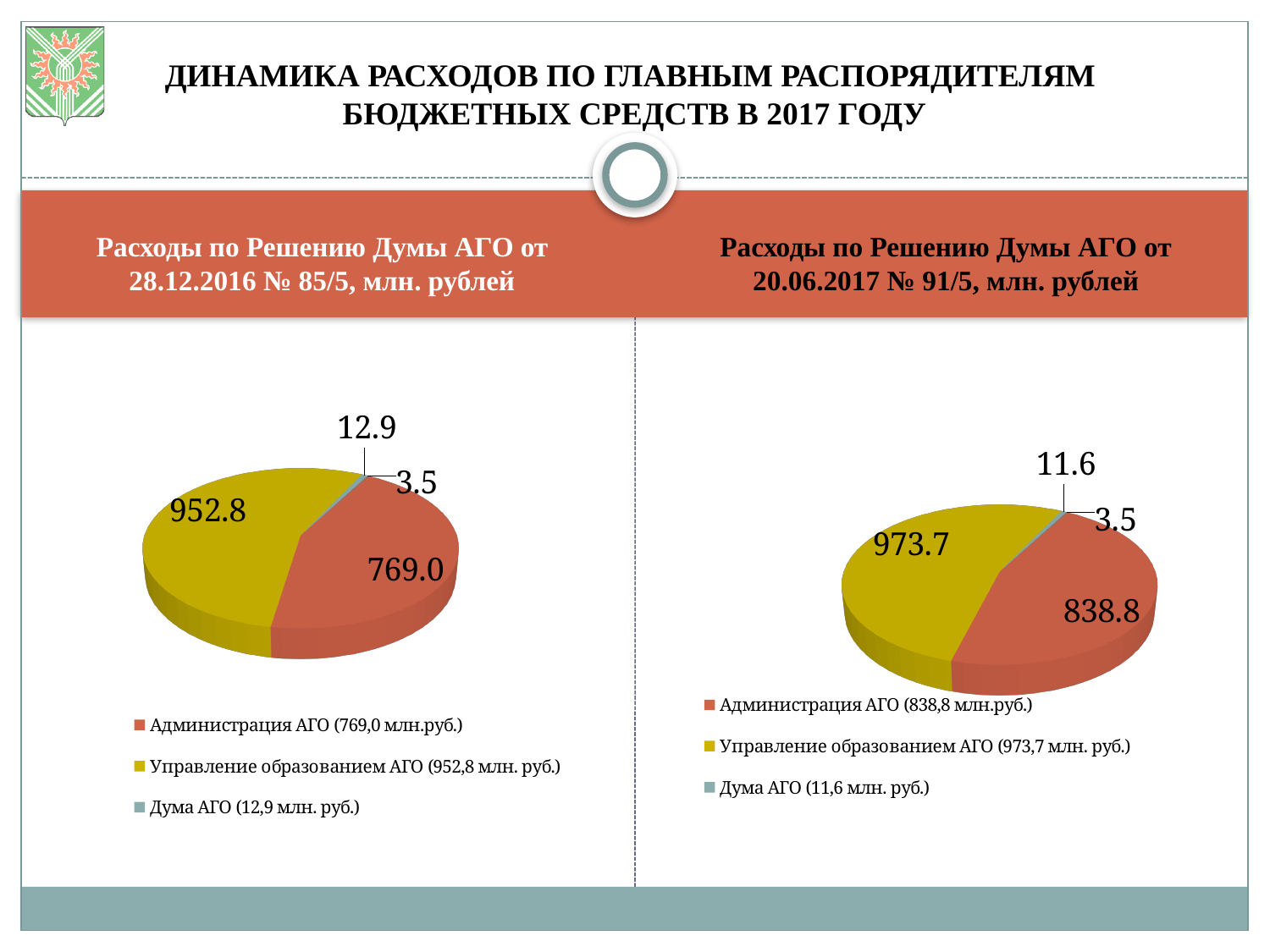
In the left pie chart (Расходы по Решению Думы АГО от 28.12.2016 № 85/5), which category has the largest slice? Управление образованием АГО What type of chart is used on the left side of the slide? Pie chart In the left pie chart (Расходы по Решению Думы АГО от 28.12.2016 № 85/5), what is the difference between Управление образованием АГО and Администрация АГО? 183.8 In the right pie chart (Расходы по Решению Думы АГО от 20.06.2017 № 91/5), what is the value for Управление образованием АГО? 973.7 In the left pie chart (Расходы по Решению Думы АГО от 28.12.2016 № 85/5), what is the value for Администрация АГО? 769.0 In the right pie chart (Расходы по Решению Думы АГО от 20.06.2017 № 91/5), which category has the largest slice? Управление образованием АГО In the right pie chart (Расходы по Решению Думы АГО от 20.06.2017 № 91/5), what is the value for Дума АГО? 11.6 Which is larger: the value for Администрация АГО in the left pie chart or in the right pie chart? The right pie chart In the right pie chart (Расходы по Решению Думы АГО от 20.06.2017 № 91/5), what is the value for Администрация АГО? 838.8 In the left pie chart (Расходы по Решению Думы АГО от 28.12.2016 № 85/5), what is the value for Управление образованием АГО? 952.8 In the right pie chart (Расходы по Решению Думы АГО от 20.06.2017 № 91/5), what is the difference between Управление образованием АГО and Администрация АГО? 134.9 In the left pie chart (Расходы по Решению Думы АГО от 28.12.2016 № 85/5), what is the value for Дума АГО? 12.9